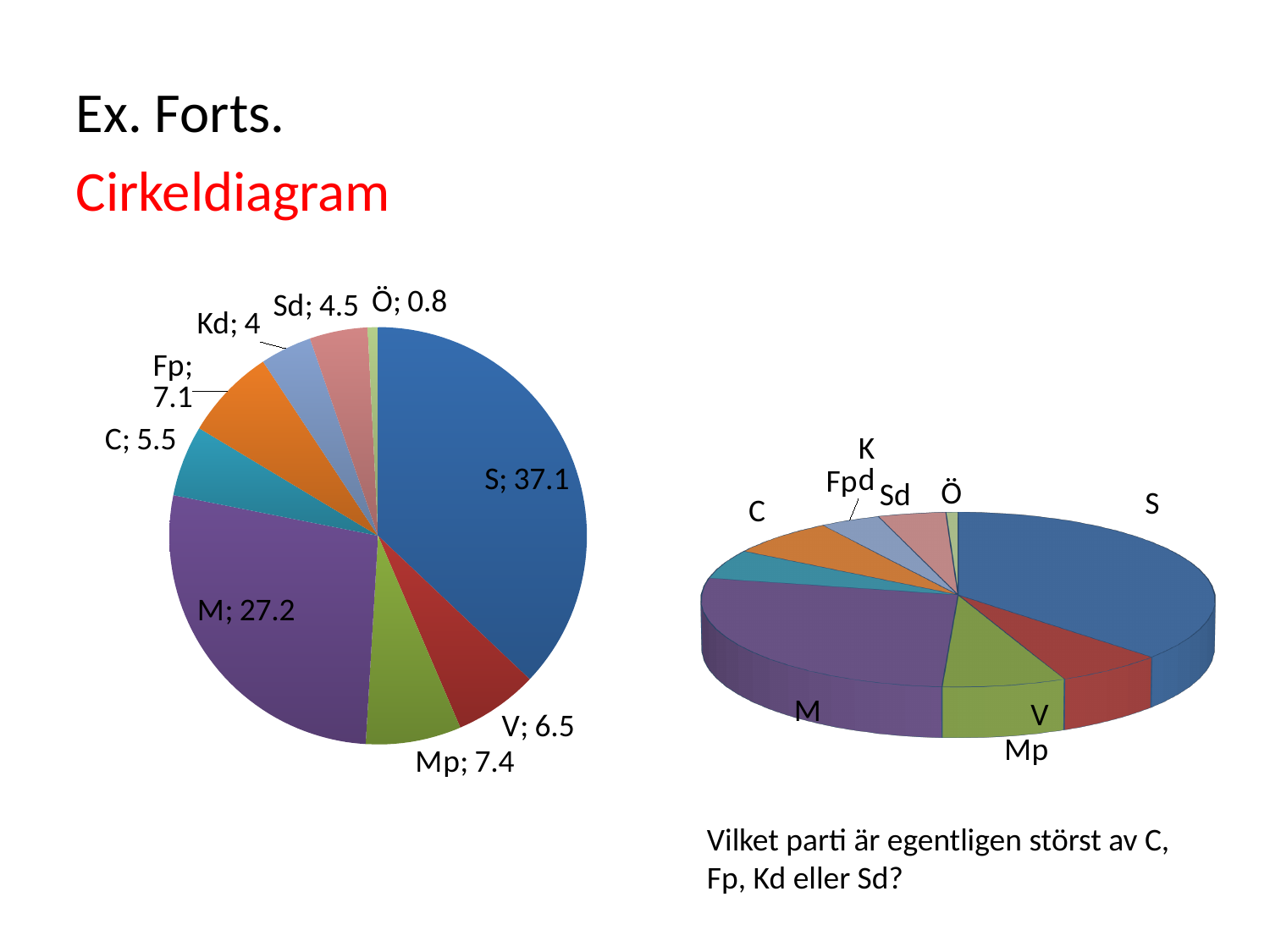
On the left pie chart, what is the difference between the values for S and M? 9.9 On the left pie chart, which category has the largest slice? S On the left pie chart, what value is shown for M? 27.2 On the left pie chart, which category has the smallest slice? Ö On the left pie chart, what value is shown for Ö? 0.8 On the left pie chart, what value is shown for S? 37.1 On the left pie chart, what is the difference between the values for Fp and C? 1.6 What kind of chart is shown on the right side of the slide? Pie chart On the left pie chart, which is larger, Mp or Fp? Mp On the left pie chart, which is larger, Kd or Sd? Sd How many slices does the left pie chart have? 9 On the left pie chart, what value is shown for Fp? 7.1